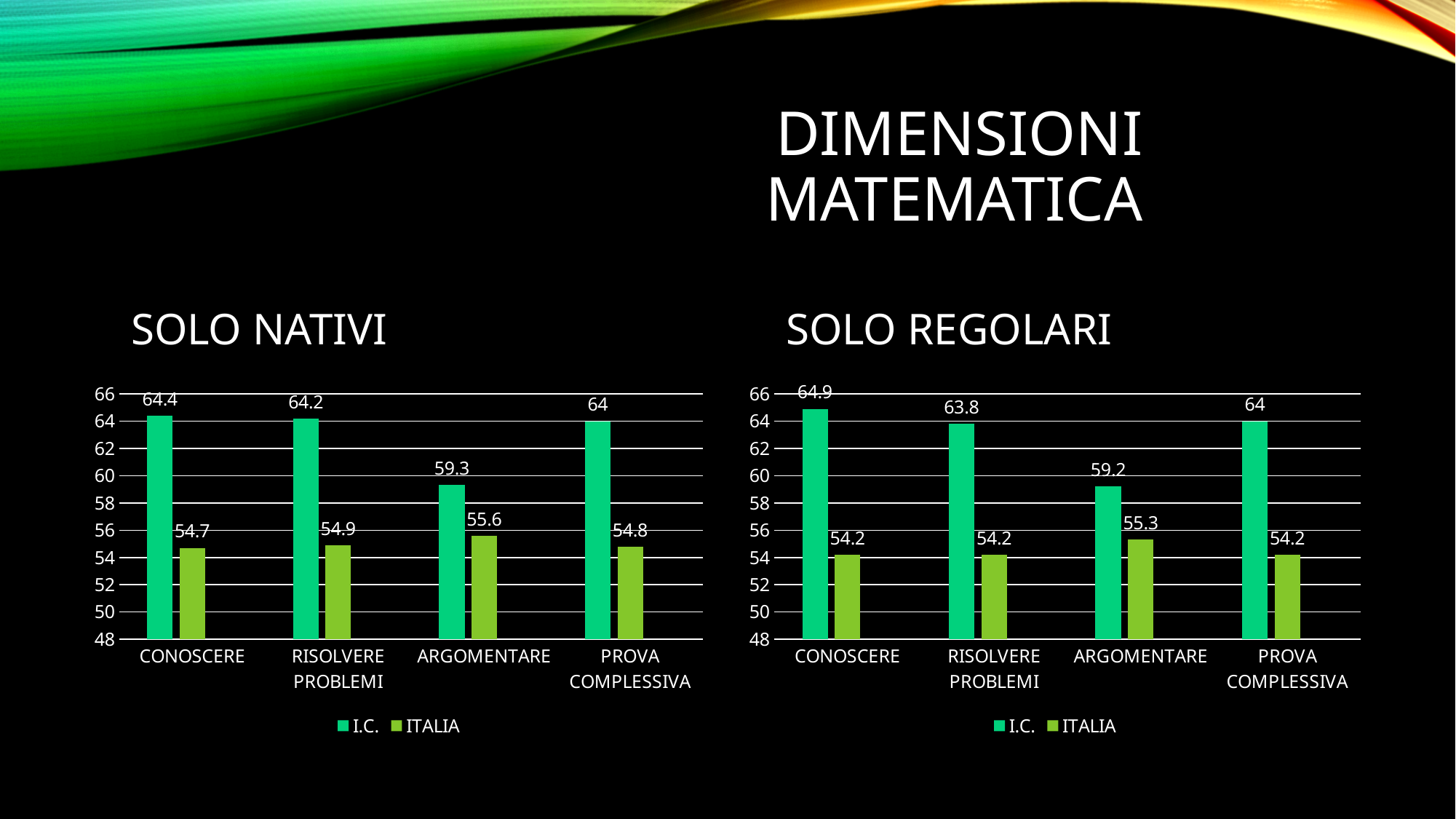
In the SOLO REGOLARI chart, which category has the highest I.C. value? CONOSCERE In the SOLO NATIVI chart, what is the difference between the I.C. and ITALIA values for CONOSCERE? 9.7 In the SOLO NATIVI chart, what is the I.C. value for CONOSCERE? 64.4 In the SOLO REGOLARI chart, what is the I.C. value for RISOLVERE PROBLEMI? 63.8 In the SOLO NATIVI chart, what is the ITALIA value for ARGOMENTARE? 55.6 In the SOLO REGOLARI chart, what is the ITALIA value for PROVA COMPLESSIVA? 54.2 In the SOLO NATIVI chart, which is larger for RISOLVERE PROBLEMI: the I.C. value or the ITALIA value? I.C. In the SOLO REGOLARI chart, what is the difference between the I.C. and ITALIA values for ARGOMENTARE? 3.9 In the SOLO NATIVI chart, which category has the lowest I.C. value? ARGOMENTARE How many series does the legend of the SOLO NATIVI chart list? 2 How many categories are shown on the x axis of the SOLO REGOLARI chart? 4 What type of chart is the SOLO REGOLARI chart? Bar chart